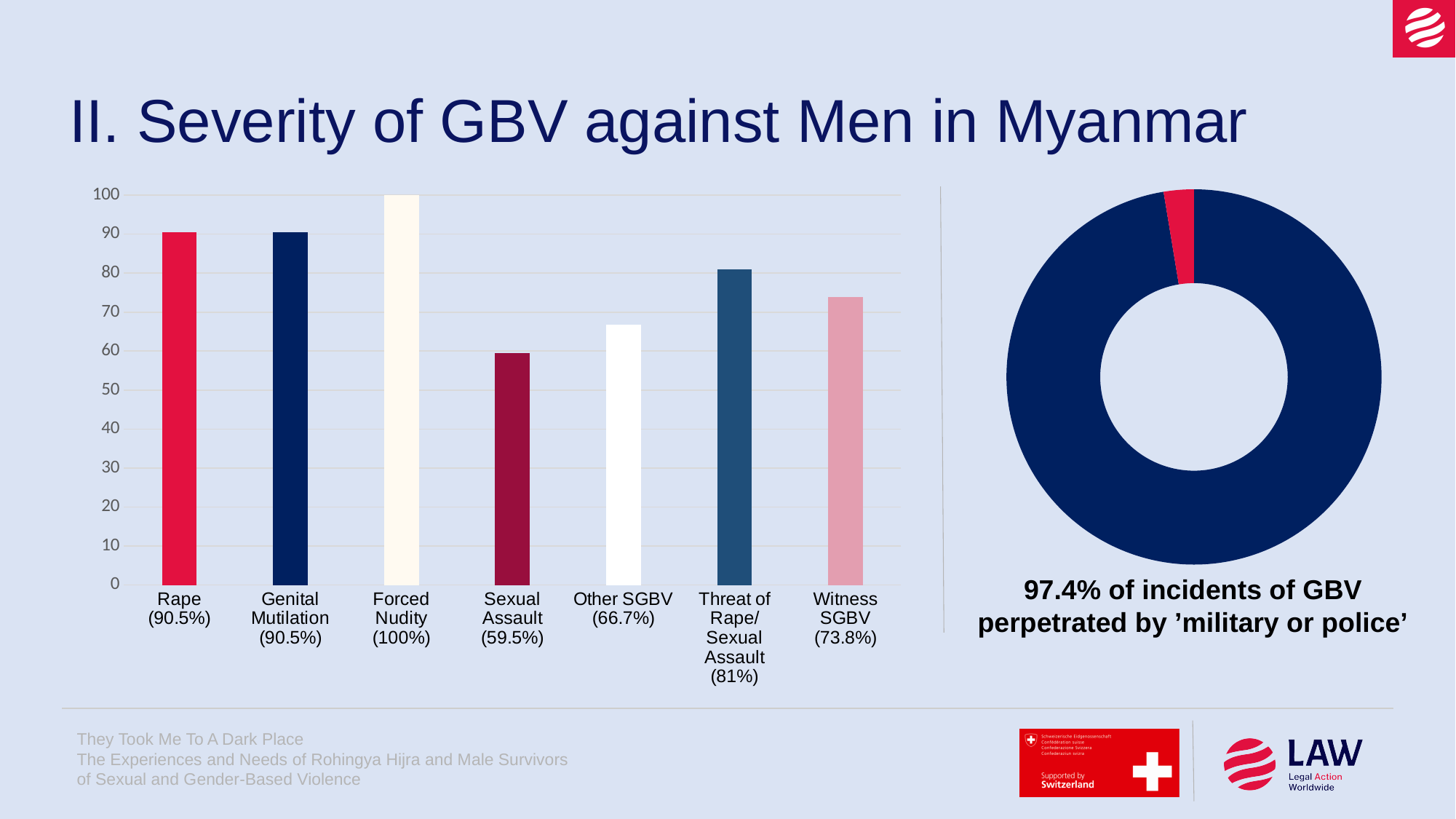
On the bar chart, what is the difference between the values for Forced Nudity and Sexual Assault? 40.5 percentage points On the bar chart, is the value for Threat of Rape/Sexual Assault greater or less than 70? greater On the bar chart, what is the value for Sexual Assault? 59.5% On the bar chart, what is the value for Witness SGBV? 73.8% On the bar chart, which is larger: the value for Other SGBV or the value for Witness SGBV? Witness SGBV On the bar chart, which category has the highest value? Forced Nudity On the bar chart, what is the value for Threat of Rape/Sexual Assault? 81% What kind of chart is shown on the left of the slide? Bar chart On the bar chart, which category has the lowest value? Sexual Assault On the bar chart, what is the value for Forced Nudity? 100% According to the donut chart on the right, what share of incidents of GBV were perpetrated by 'military or police'? 97.4% How many categories does the bar chart show? 7